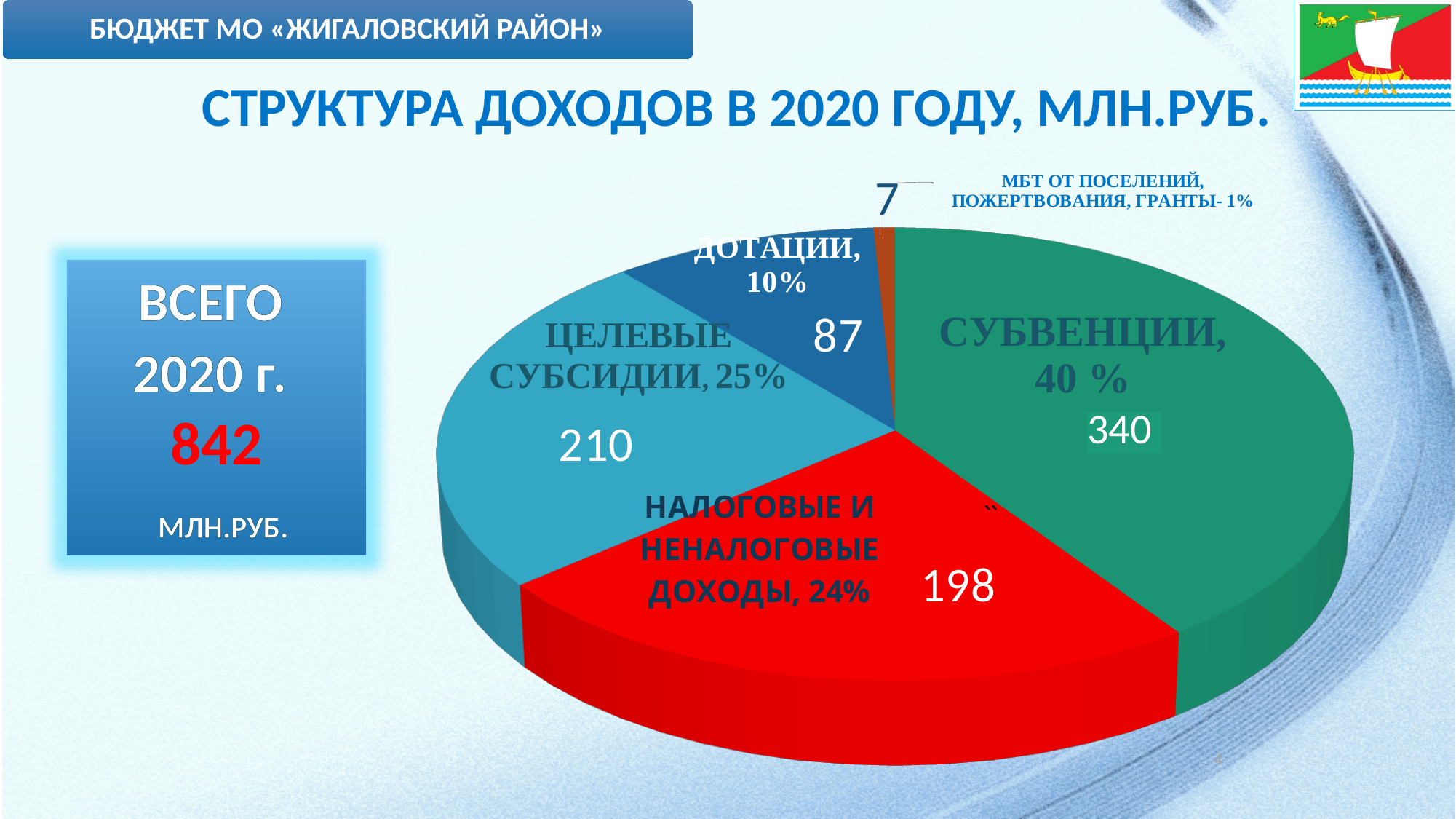
What kind of chart is shown on the slide? pie chart What is the value for ЦЕЛЕВЫЕ СУБСИДИИ in the pie chart? 210 What is the value for ДОТАЦИИ in the pie chart? 87 Which is larger, the value for ЦЕЛЕВЫЕ СУБСИДИИ or the value for ДОТАЦИИ? ЦЕЛЕВЫЕ СУБСИДИИ What is the value for СУБВЕНЦИИ in the pie chart? 340 What is the value for МБТ ОТ ПОСЕЛЕНИЙ, ПОЖЕРТВОВАНИЯ, ГРАНТЫ in the pie chart? 7 What share of the pie does НАЛОГОВЫЕ И НЕНАЛОГОВЫЕ ДОХОДЫ represent? 24% How many slices does the pie chart have? 5 Which category has the largest slice in the pie chart? СУБВЕНЦИИ What share of the pie does СУБВЕНЦИИ represent? 40 % Which category has the smallest slice in the pie chart? МБТ ОТ ПОСЕЛЕНИЙ, ПОЖЕРТВОВАНИЯ, ГРАНТЫ What is the difference between the values for СУБВЕНЦИИ and НАЛОГОВЫЕ И НЕНАЛОГОВЫЕ ДОХОДЫ? 142